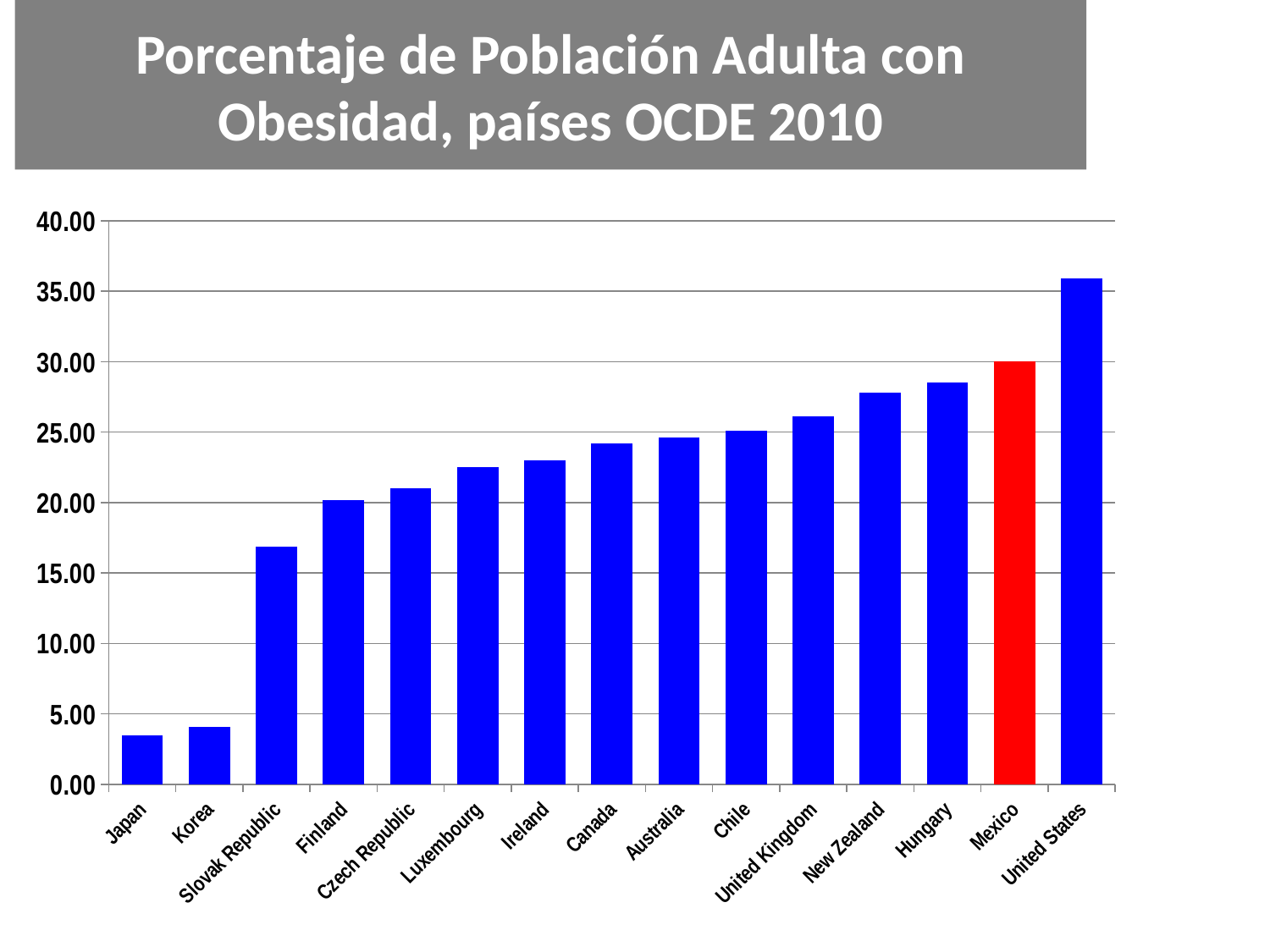
Is the value for Slovak Republic greater or less than 15.00? greater Is the value for Ireland greater or less than 25.00? less What kind of chart is shown on the slide? bar chart How many countries are shown on the x axis? 15 Which has a higher value, Korea or Finland? Finland Which country has the highest percentage of adult population with obesity? United States Which country has the lowest percentage of adult population with obesity? Japan Is the value for United States greater or less than 35.00? greater Which country's bar is coloured red instead of blue? Mexico Do the values rise or fall from left to right along the x axis? rise Which has a higher value, Hungary or Chile? Hungary